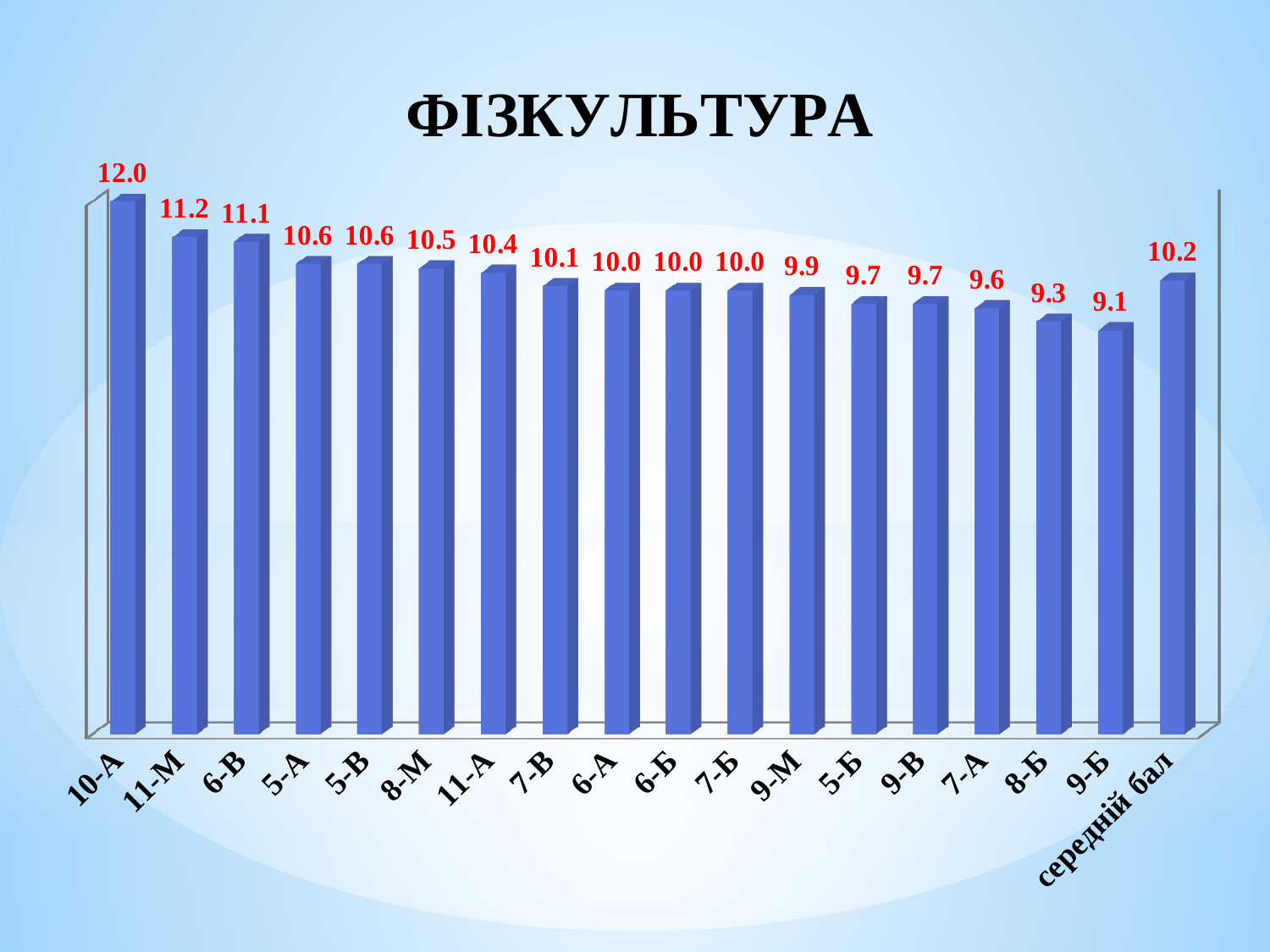
What is the difference between the values for 10-А and 9-Б? 2.9 What is the difference between the values for 11-М and 7-А? 1.6 Which category has the highest value? 10-А What is the title of the chart? ФІЗКУЛЬТУРА What kind of chart is shown on the slide? Bar chart What is the value for 9-Б? 9.1 How many bars are shown in the chart? 18 What is the value labelled 'середній бал'? 10.2 What is the value for 8-М? 10.5 Which is larger, the value for 6-В or the value for 8-Б? 6-В What is the value for 10-А? 12.0 Which category has the lowest value? 9-Б